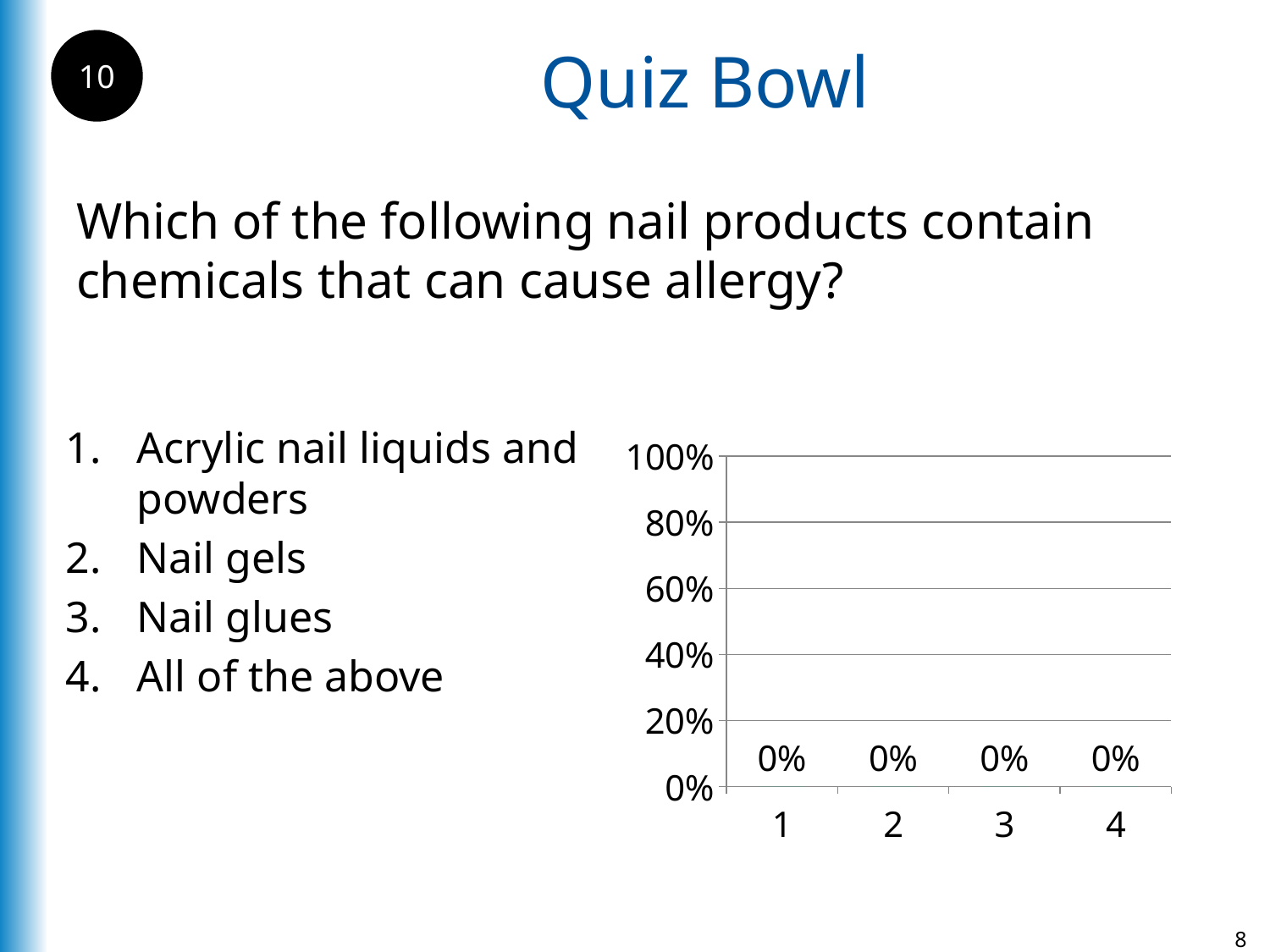
What type of chart is shown on the slide? bar chart What is the highest value shown on the y axis of the chart? 100% What value is shown for category 3 on the chart? 0% Is the value for category 2 greater or less than 20%? less What is the difference between the values for category 2 and category 4? 0% How many categories are shown on the x axis of the chart? 4 What value is shown for category 4 on the chart? 0% What value is shown for category 1 on the chart? 0% What is the total of the values for all four categories on the chart? 0% What is the interval between the y-axis tick labels on the chart? 20%